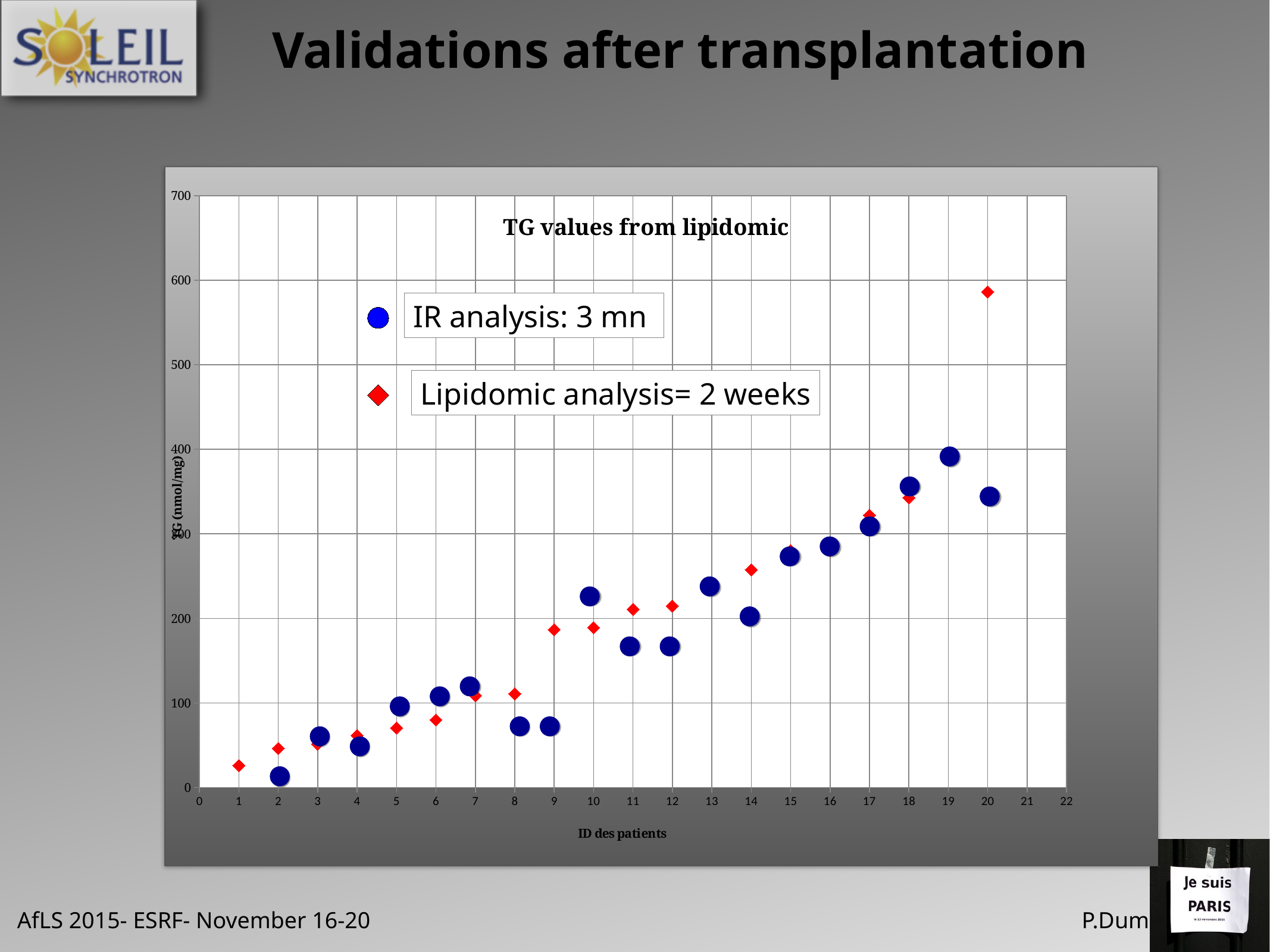
Is the Lipidomic analysis value for patient 20 greater or less than 500? greater What kind of chart is shown on the slide? Scatter chart How many series does the legend list? 2 Which patient ID has the lowest IR analysis value? 2 Do the TG values generally rise or fall as the patient ID increases? Rise Which patient ID has the highest IR analysis value? 19 Is the IR analysis value for patient 10 greater or less than 200? greater What is the label of the x axis? ID des patients Is the IR analysis value for patient 19 greater or less than 300? greater For patient 20, which series has the higher value, IR analysis or Lipidomic analysis? Lipidomic analysis Which patient ID has the highest Lipidomic analysis value? 20